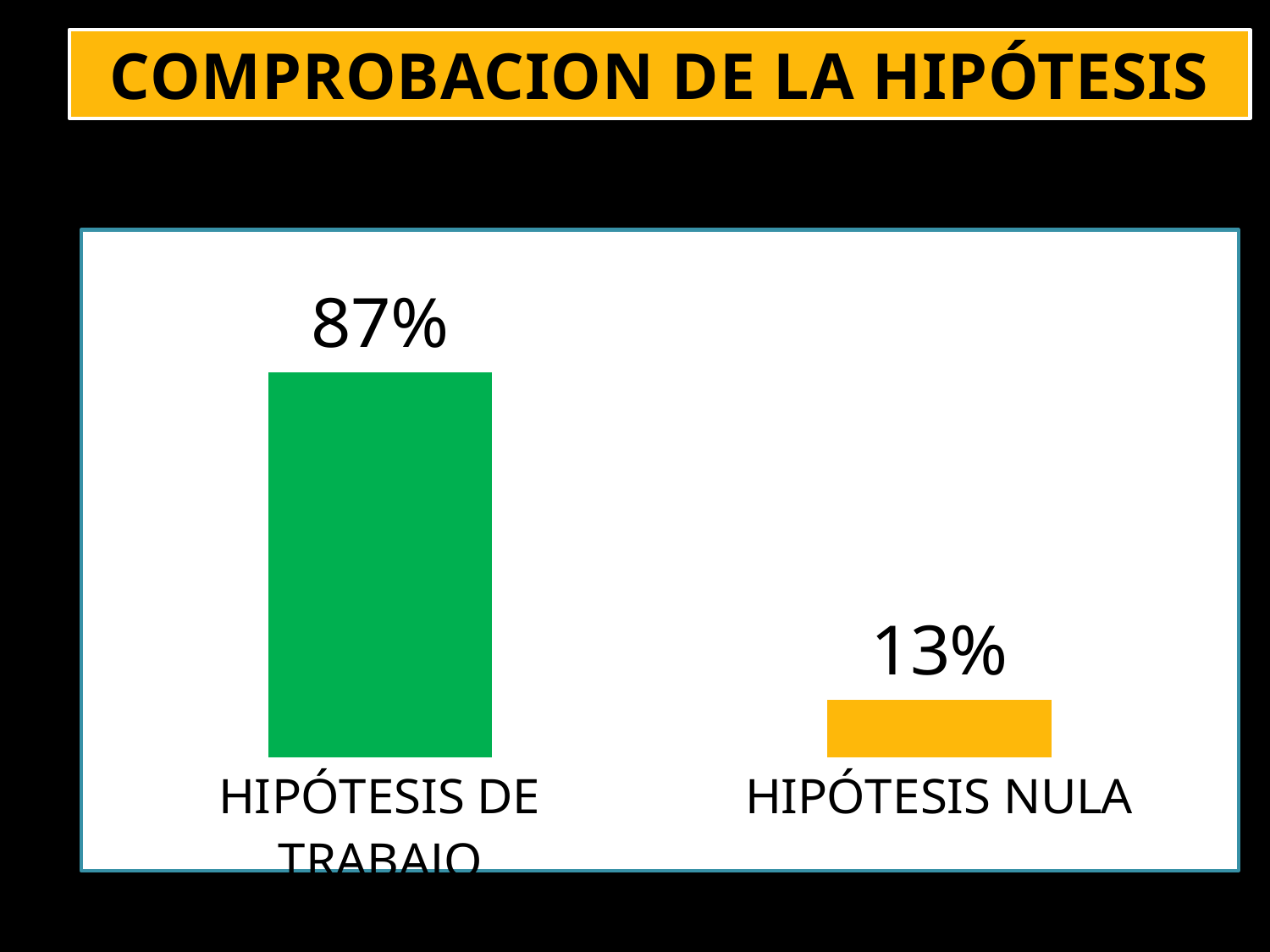
What is the difference between the values for HIPÓTESIS DE TRABAJO and HIPÓTESIS NULA? 74% What colour is the bar for HIPÓTESIS NULA? yellow What kind of chart is shown on the slide? bar chart What is the value for HIPÓTESIS NULA? 13% What is the total of the two values shown in the chart? 100% Which category has the lowest value? HIPÓTESIS NULA What is the value for HIPÓTESIS DE TRABAJO? 87% Which category has the highest value? HIPÓTESIS DE TRABAJO How many categories are shown in the chart? 2 What is the title shown above the chart on the slide? COMPROBACION DE LA HIPÓTESIS Which is larger, the value for HIPÓTESIS DE TRABAJO or the value for HIPÓTESIS NULA? HIPÓTESIS DE TRABAJO